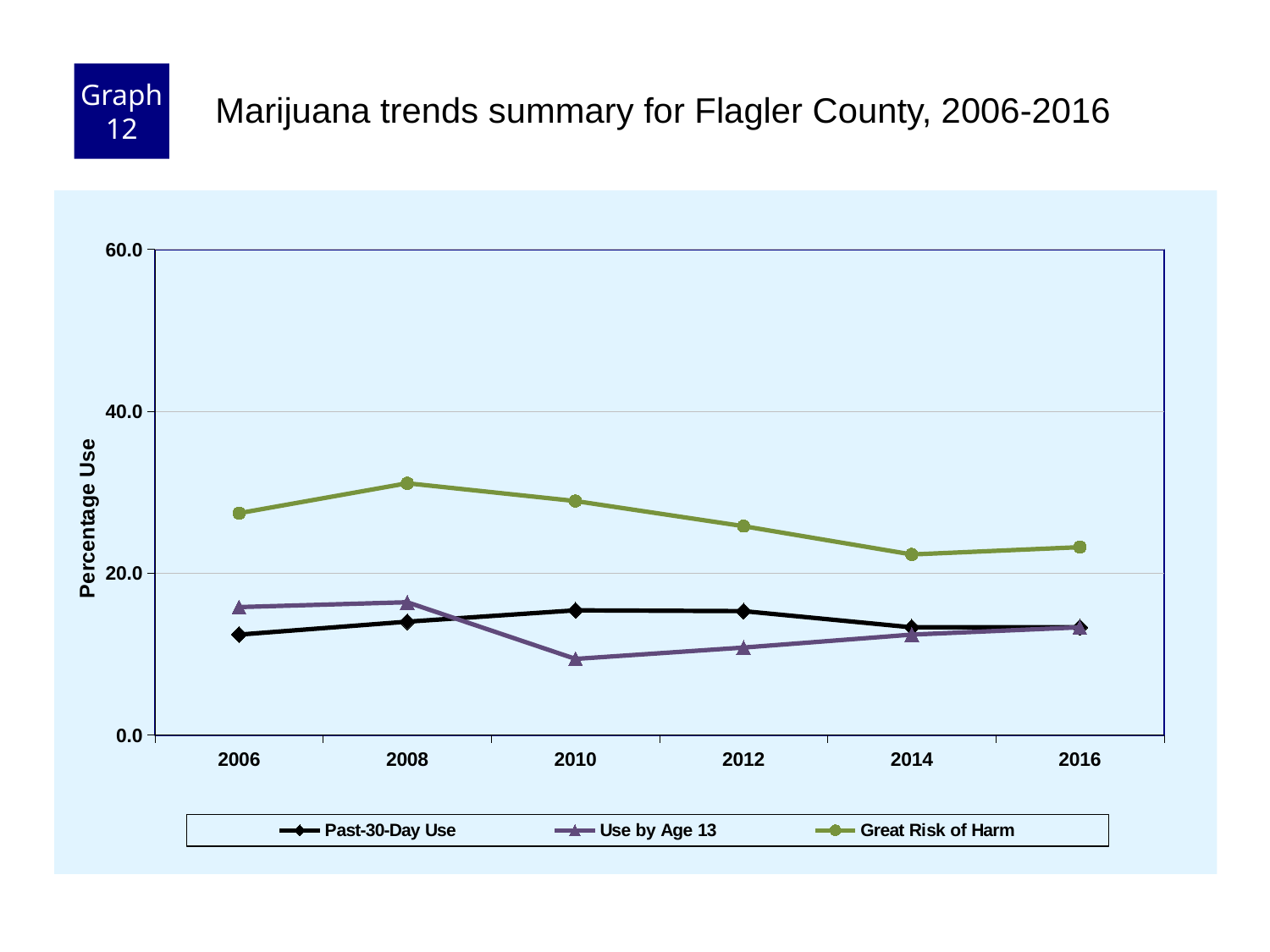
Does the Great Risk of Harm line rise or fall from 2008 to 2014? Fall Is the value for Great Risk of Harm in 2008 greater or less than 20.0? greater In 2010, which is larger: Past-30-Day Use or Use by Age 13? Past-30-Day Use What kind of chart is shown on the slide? Line chart In which year is the Use by Age 13 value lowest? 2010 How many series does the legend list? 3 In which year is the Great Risk of Harm value highest? 2008 What is the label on the y axis? Percentage Use Is the value for Use by Age 13 in 2010 greater or less than 20.0? less Which series has the highest values across all years? Great Risk of Harm How many years are plotted along the x axis? 6 Is the value for Great Risk of Harm in 2008 greater or less than 40.0? less